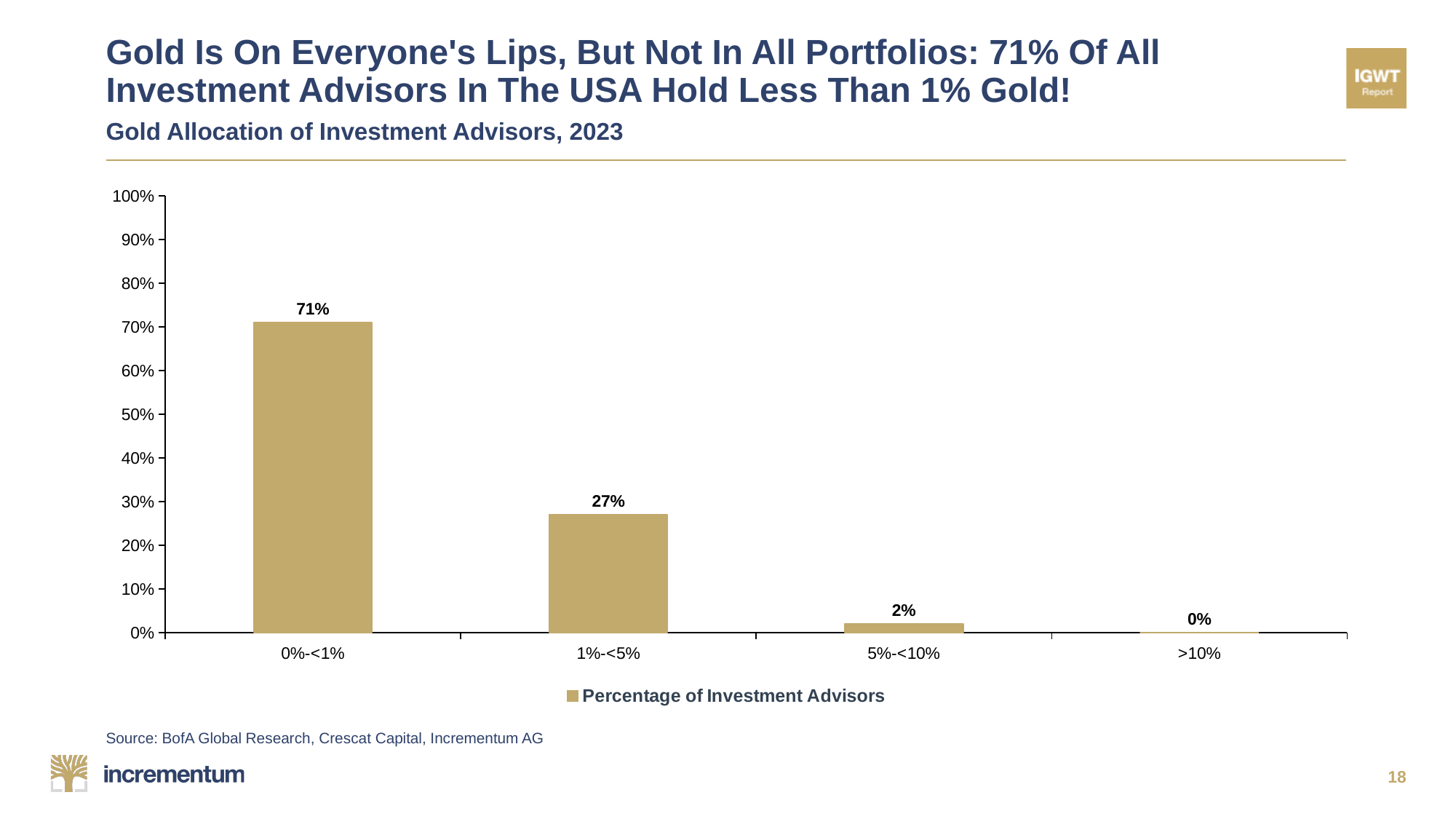
What percentage of investment advisors hold 0%-<1% gold? 71% What type of chart is shown on the slide? Bar chart Is the value for the 0%-<1% category greater or less than 60%? greater What is the difference in percentage points between the 0%-<1% and 1%-<5% categories? 44 What percentage of investment advisors hold 1%-<5% gold? 27% How many gold allocation categories are shown on the x axis? 4 What percentage of investment advisors hold 5%-<10% gold? 2% Which category has a larger share of investment advisors: 1%-<5% or 5%-<10%? 1%-<5% What percentage of investment advisors hold >10% gold? 0% Which gold allocation category has the highest percentage of investment advisors? 0%-<1% What is the name of the series listed in the legend? Percentage of Investment Advisors Which gold allocation category has the lowest percentage of investment advisors? >10%